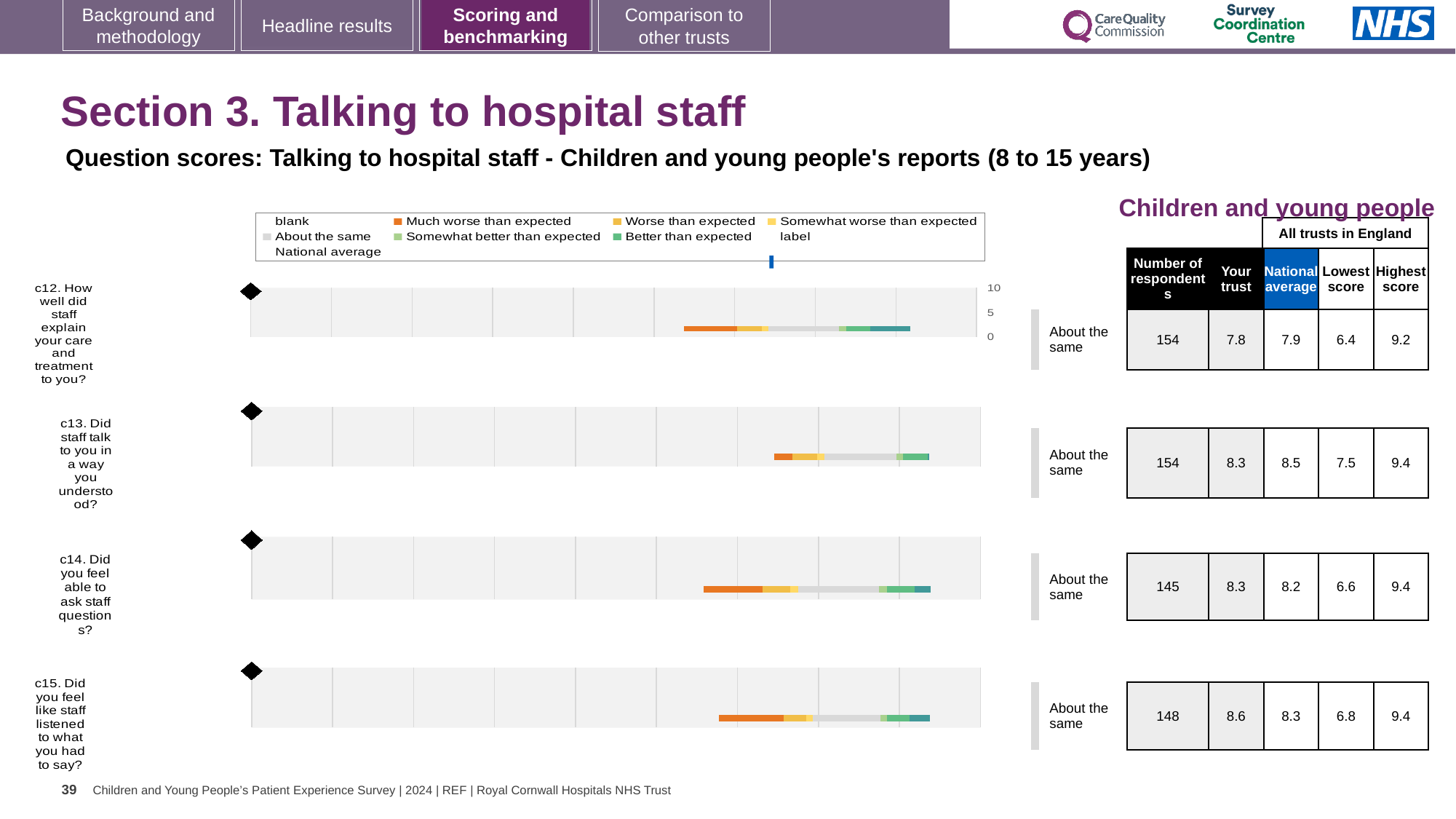
Which question (c12 to c15) has the highest Your trust score in the table? c15 What is the first entry in the legend above the charts? blank How many entries does the shared legend above the charts list? 9 In the table beside the c12 chart, what is the number of respondents? 154 In the table beside the c13 chart (Did staff talk to you in a way you understood?), what is the National average? 8.5 For the c14 chart (Did you feel able to ask staff questions?), which is larger in the table: Your trust or National average? Your trust What is the highest tick value shown on the vertical axis of the c12 chart? 10 How many question charts (c12 to c15) are shown on the slide? 4 What benchmark label is shown next to the c13 chart? About the same What kind of chart is used for question c12 (How well did staff explain your care and treatment to you?)? bar chart In the table beside the c15 chart (Did you feel like staff listened to what you had to say?), what is the Your trust score? 8.6 For the c15 chart, what is the difference between the Highest score and the Lowest score in the table? 2.6